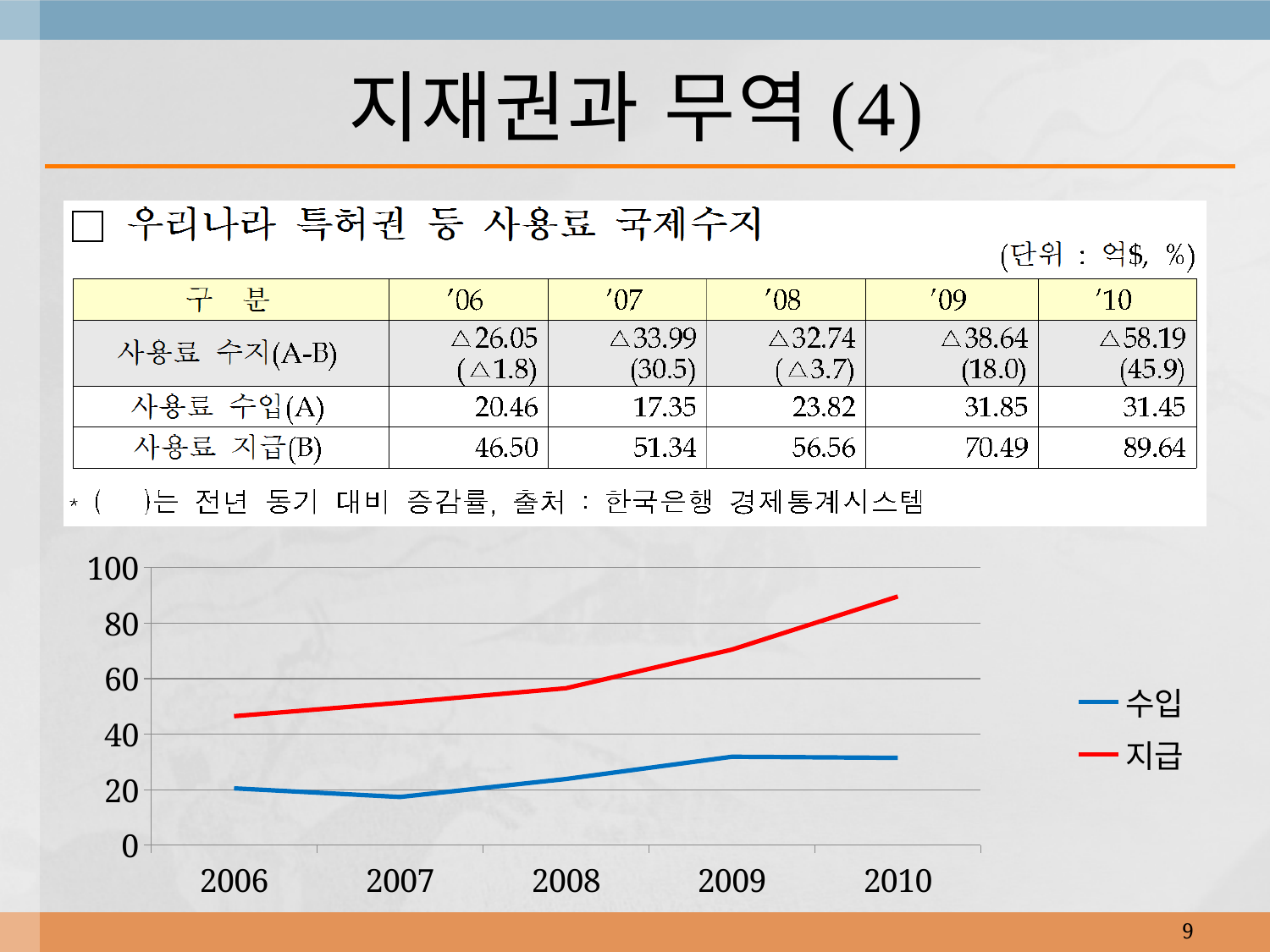
In the line chart, in which year is the 수입 line at its lowest? 2007 What are the two legend entries of the line chart? 수입, 지급 In the line chart, is the value for 수입 in 2007 greater or less than 20? less According to the table on the slide, what is the value of 사용료 수입(A) for '09? 31.85 In the line chart, which series is higher in 2010, 수입 or 지급? 지급 In the line chart, is the value for 지급 in 2010 greater or less than 80? greater In the line chart, in which year is the 지급 line at its highest? 2010 In the line chart, does the 지급 line rise or fall from 2006 to 2010? rise What kind of chart is shown at the bottom of the slide? line chart How many years are plotted along the x axis of the line chart? 5 According to the table on the slide, what is the value of 사용료 지급(B) for '10? 89.64 How many series does the legend of the line chart list? 2